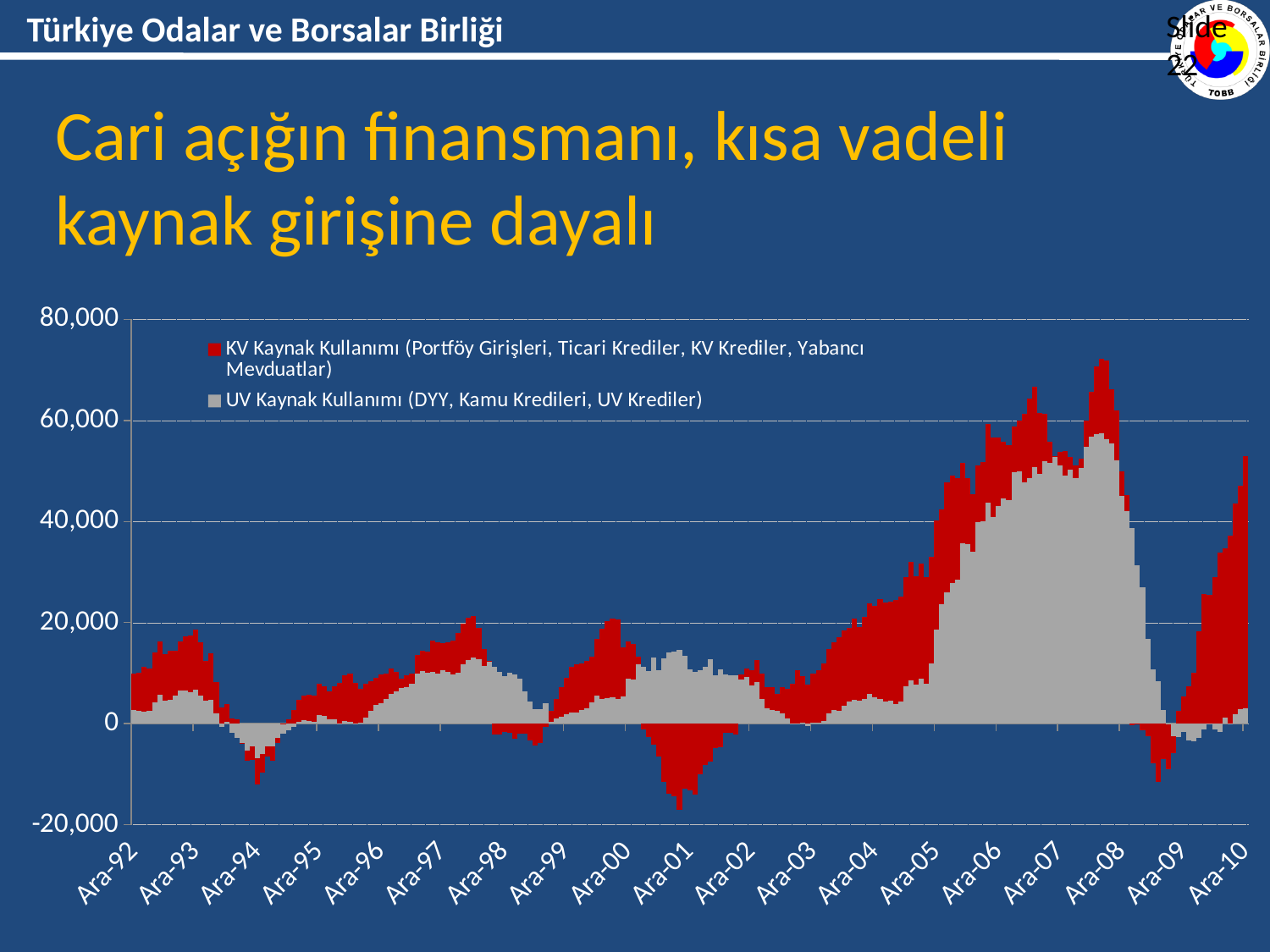
How many date labels are shown on the x axis of the chart? 19 What is the lowest value shown on the y axis of the chart? -20,000 How many series does the chart legend list? 2 Is the total stacked value around Ara-10 greater or less than 40,000? greater Is the value of KV Kaynak Kullanımı around Ara-01 greater or less than 0? less Which series is shown in gray in the chart? UV Kaynak Kullanımı (DYY, Kamu Kredileri, UV Krediler) What kind of chart is shown on the slide? Stacked bar chart Which series is shown in red in the chart? KV Kaynak Kullanımı (Portföy Girişleri, Ticari Krediler, KV Krediler, Yabancı Mevduatlar) Does the UV Kaynak Kullanımı series rise or fall between Ara-08 and Ara-09? fall What is the highest value shown on the y axis of the chart? 80,000 Is the value of UV Kaynak Kullanımı around Ara-07 greater or less than 40,000? greater